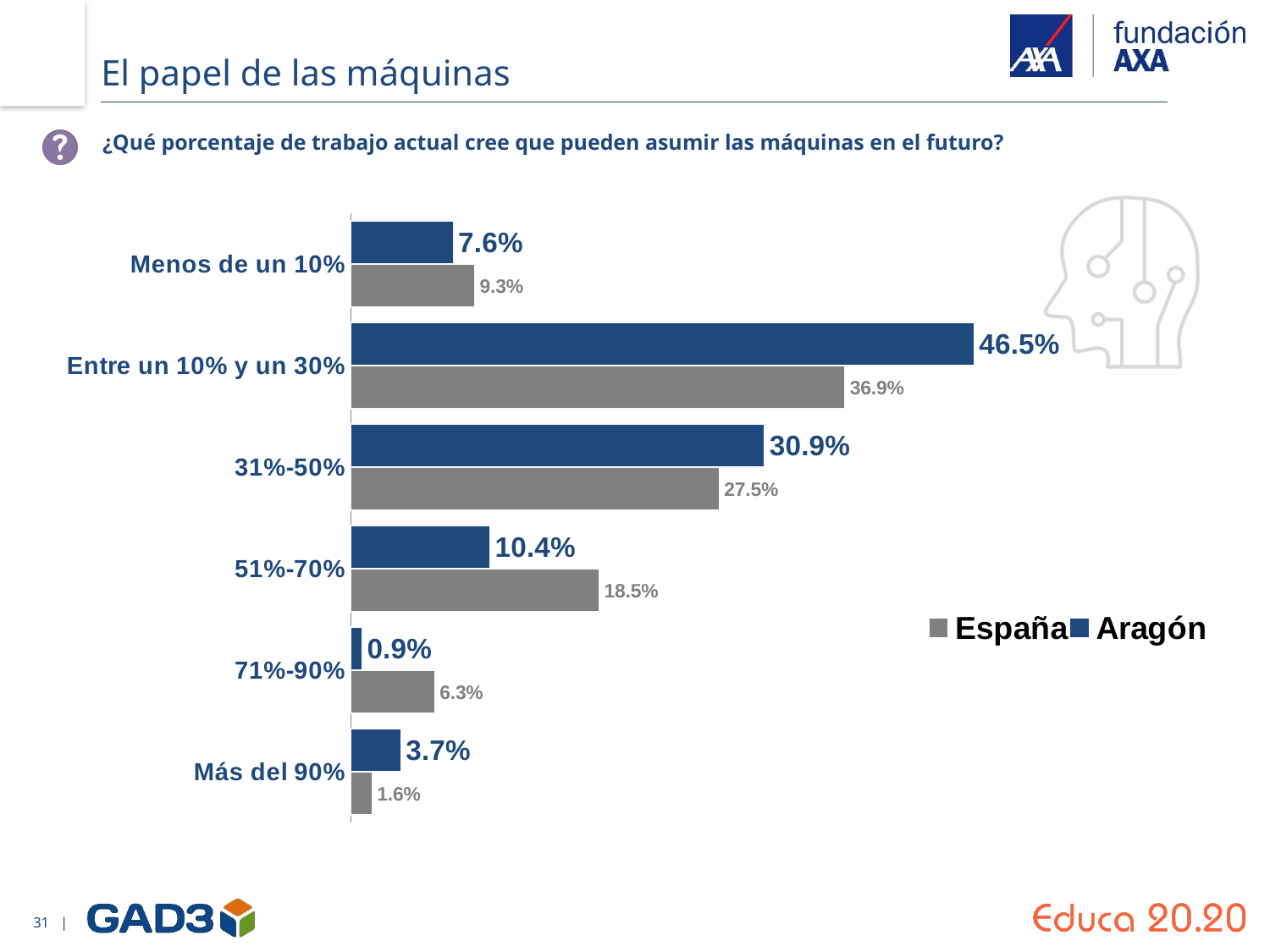
What is the value for España in the 'Menos de un 10%' category? 9.3% What is the value for España in the '51%-70%' category? 18.5% Which category has the highest value for España? Entre un 10% y un 30% Which category has the lowest value for Aragón? 71%-90% How many series does the legend list? 2 In the '31%-50%' category, which series has the larger value, España or Aragón? Aragón How many categories are shown on the chart? 6 What is the value for Aragón in the '71%-90%' category? 0.9% In the 'Más del 90%' category, which series has the larger value, España or Aragón? Aragón What is the difference between the Aragón and España values in the 'Entre un 10% y un 30%' category? 9.6 percentage points What kind of chart is shown on the slide? Bar chart What is the value for Aragón in the 'Entre un 10% y un 30%' category? 46.5%